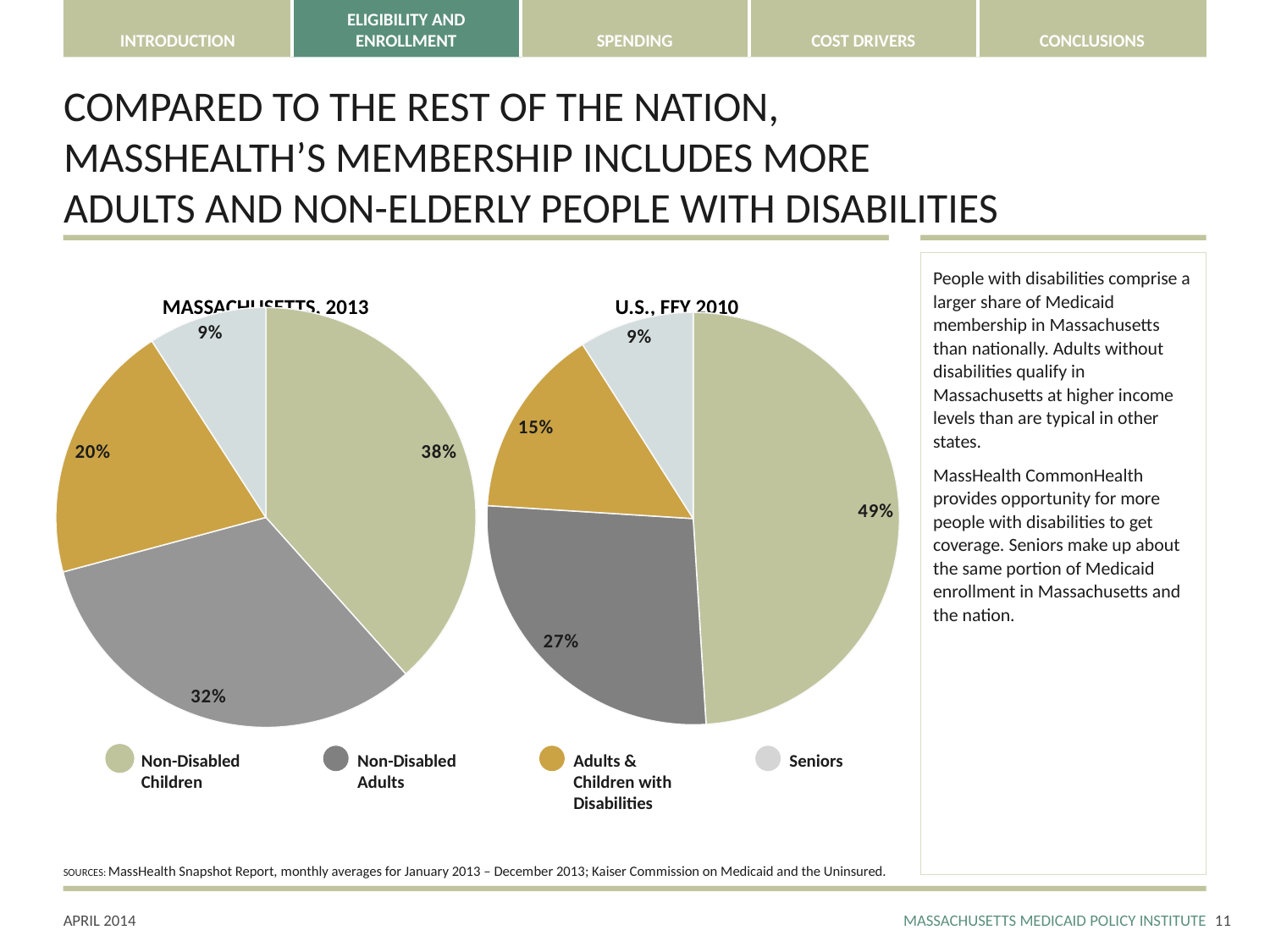
What is the Seniors share in the Massachusetts, 2013 pie chart? 9% In the Massachusetts, 2013 pie chart, which category has the largest share? Non-Disabled Children In the U.S., FFY 2010 pie chart, which category has the smallest share? Seniors In the U.S., FFY 2010 pie chart, what share is Adults & Children with Disabilities? 15% Which chart shows a larger share for Non-Disabled Adults, Massachusetts, 2013 or U.S., FFY 2010? Massachusetts, 2013 In the Massachusetts, 2013 pie chart, what share is Non-Disabled Children? 38% How many slices does the U.S., FFY 2010 pie chart have? 4 What kind of chart is used for the Massachusetts, 2013 data? Pie chart In the Massachusetts, 2013 pie chart, what share is Non-Disabled Adults? 32% In the U.S., FFY 2010 pie chart, what share is Non-Disabled Children? 49% What is the difference between the Adults & Children with Disabilities share in the Massachusetts, 2013 chart and in the U.S., FFY 2010 chart? 5 percentage points How many categories does the legend list? 4